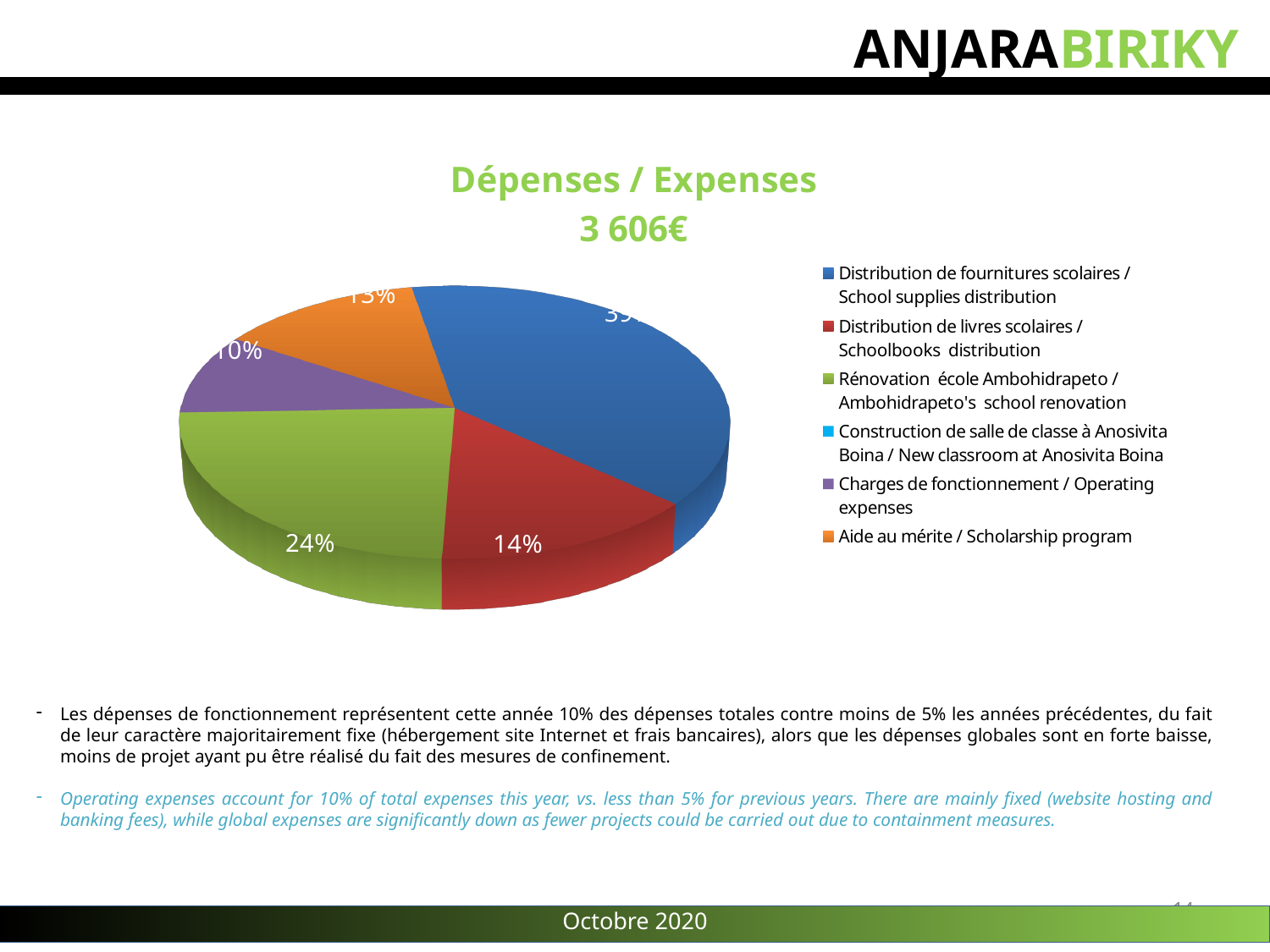
What share of expenses goes to Rénovation école Ambohidrapeto / Ambohidrapeto's school renovation? 24% What share of expenses goes to Charges de fonctionnement / Operating expenses? 10% What share of expenses goes to Distribution de livres scolaires / Schoolbooks distribution? 14% What is the difference in percentage points between the school renovation slice (24%) and the operating expenses slice (10%)? 14 percentage points Which is larger: the slice for Ambohidrapeto's school renovation or the slice for Operating expenses? Ambohidrapeto's school renovation What total amount of expenses is shown in the chart title? 3 606€ Which is larger: the slice for Ambohidrapeto's school renovation or the slice for Schoolbooks distribution? Ambohidrapeto's school renovation What kind of chart is shown on the slide? Pie chart What is the title of the pie chart? Dépenses / Expenses 3 606€ What is the difference in percentage points between the school renovation slice (24%) and the schoolbooks distribution slice (14%)? 10 percentage points How many entries does the legend of the pie chart list? 6 Which category has the largest slice of the pie chart? Distribution de fournitures scolaires / School supplies distribution